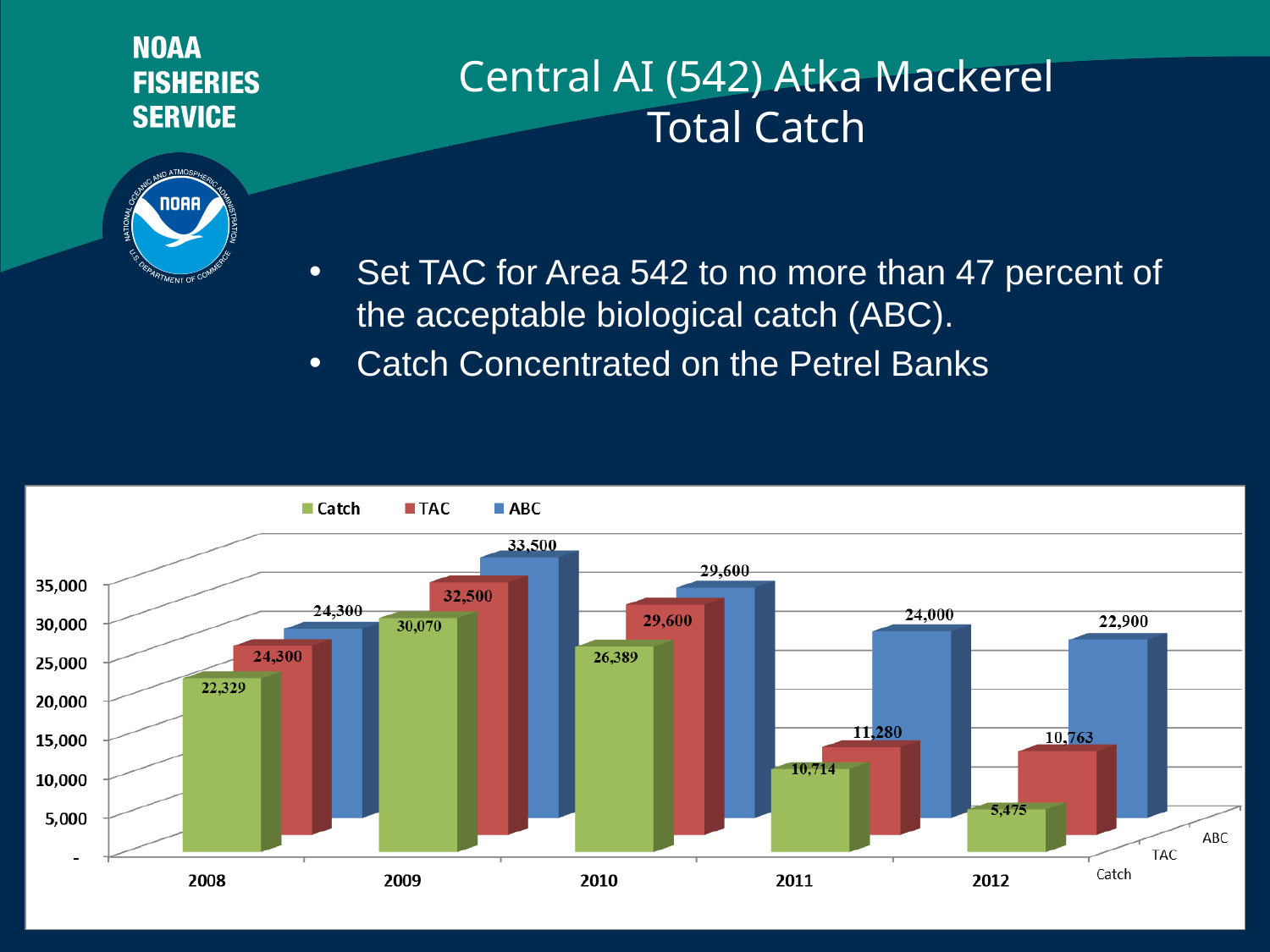
Is the Catch value for 2008 greater or less than 25,000? less How many series does the legend list? 3 How many years are shown on the x axis? 5 Which was larger in 2011, the TAC or the ABC? ABC What was the TAC value in 2011? 11,280 What is the difference between the TAC and the Catch in 2010? 3,211 Which year had the highest ABC value? 2009 What is the difference between the ABC and the Catch in 2012? 17,425 What kind of chart is shown on the slide? Bar chart What was the ABC value in 2012? 22,900 What was the Catch value in 2009? 30,070 Which year had the lowest Catch value? 2012